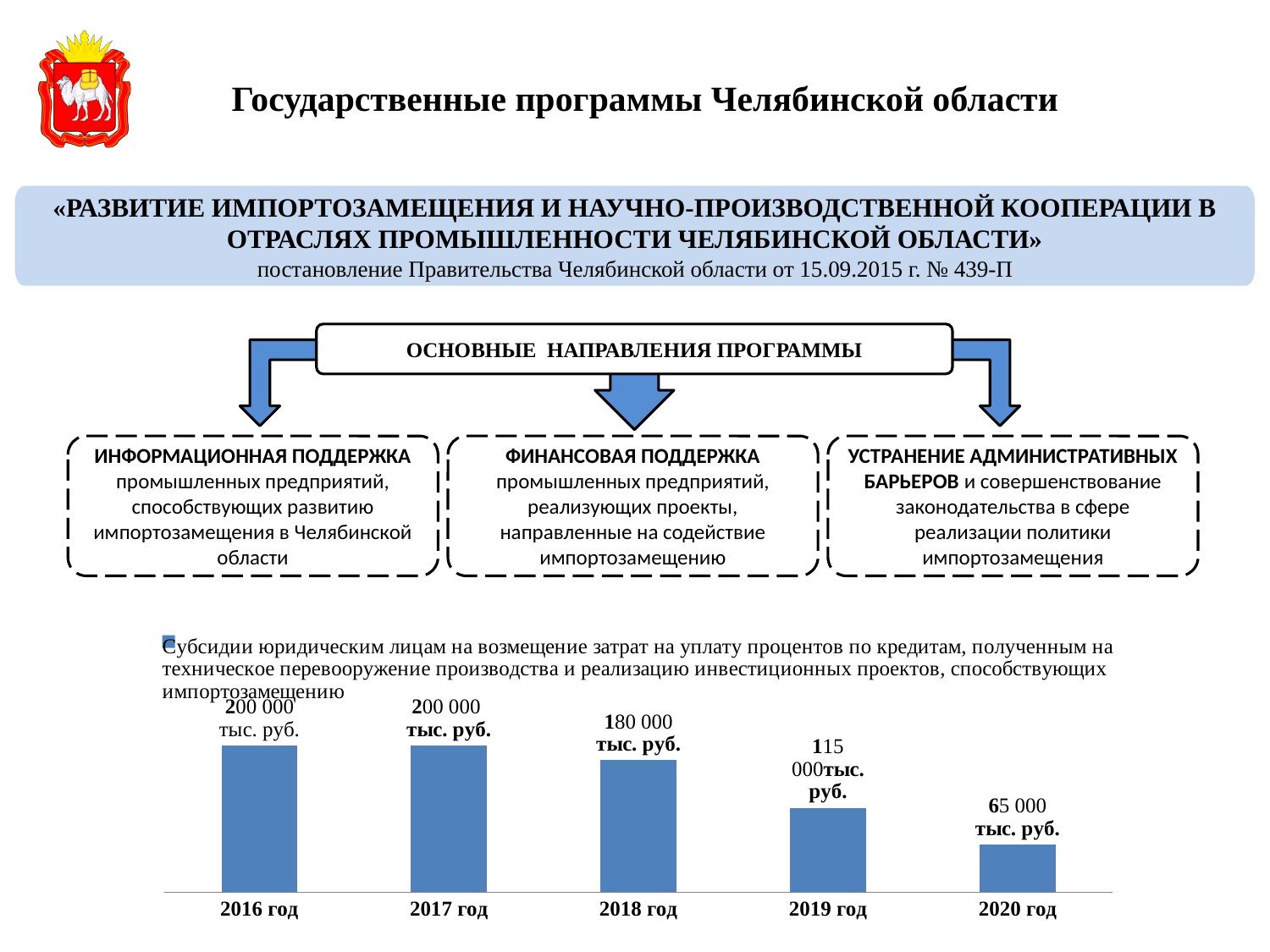
Which is larger, the value for 2017 год or the value for 2019 год? 2017 год What kind of chart is shown on the slide? bar chart What is the value for 2016 год? 200 000 тыс. руб. What is the value for 2018 год? 180 000 тыс. руб. What is the value for 2019 год? 115 000 тыс. руб. Which year has the lowest value? 2020 год What is the difference between the values for 2016 год and 2019 год? 85 000 тыс. руб. What is the value for 2020 год? 65 000 тыс. руб. How many years are shown on the chart? 5 Do the bars for 2016 год and 2017 год have the same value? yes What is the difference between the values for 2018 год and 2020 год? 115 000 тыс. руб. Do the values rise or fall from 2017 год to 2020 год? fall